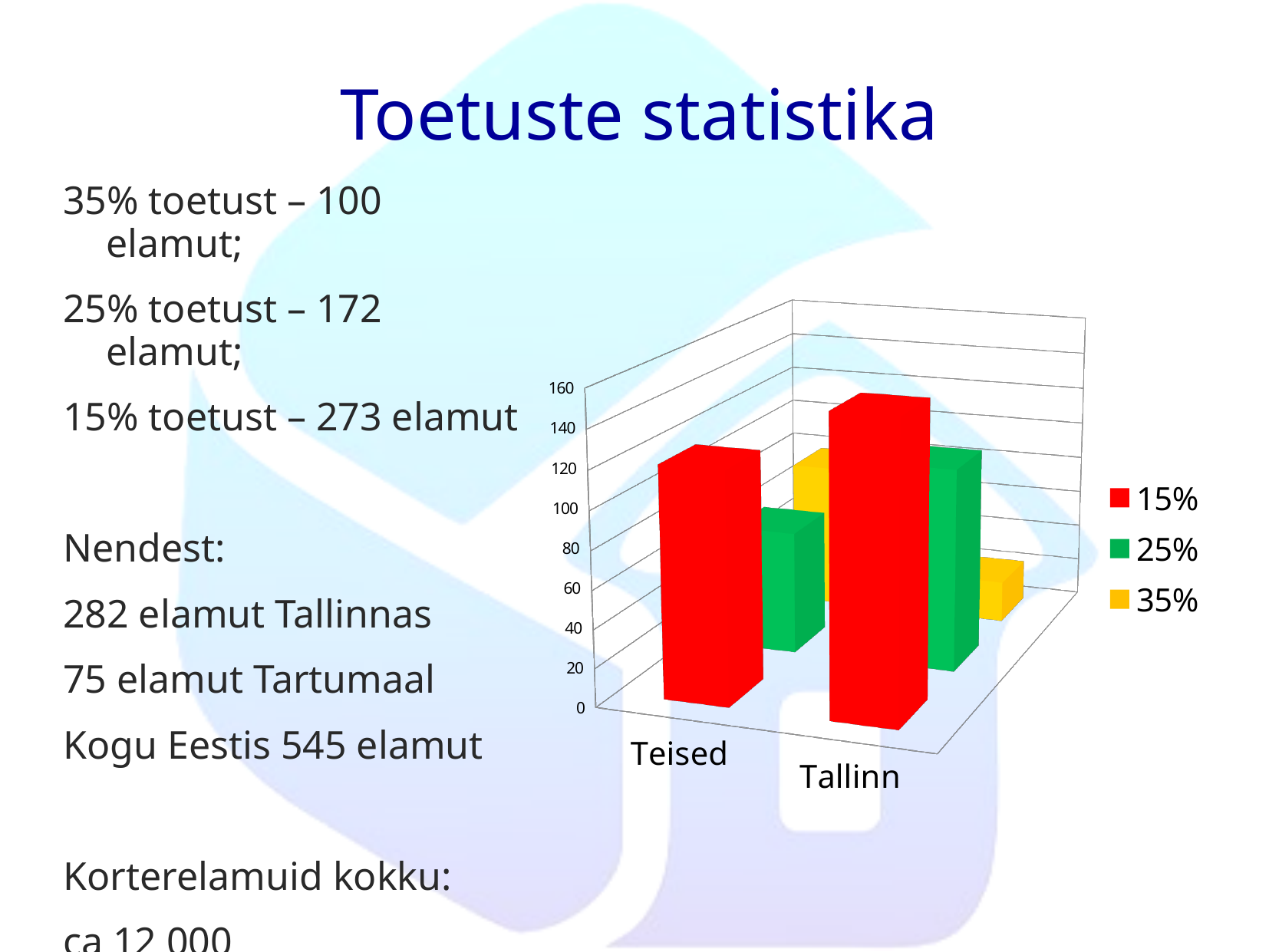
How many series does the chart legend list? 3 Is the 15% value for Teised greater or less than 80? greater Which is larger: the 35% value for Teised or the 35% value for Tallinn? Teised What colour represents the 25% series in the chart? green Which series has the lowest bar for Tallinn? 35% Is the 15% value for Tallinn greater or less than 100? greater How many categories are shown on the x axis of the chart? 2 Which is larger: the 25% value for Tallinn or the 25% value for Teised? Tallinn What is the highest value shown on the chart's vertical axis? 160 Which category has the tallest bar in the 15% series? Tallinn What kind of chart is shown on the slide? bar chart Is the 35% value for Tallinn greater or less than 100? less